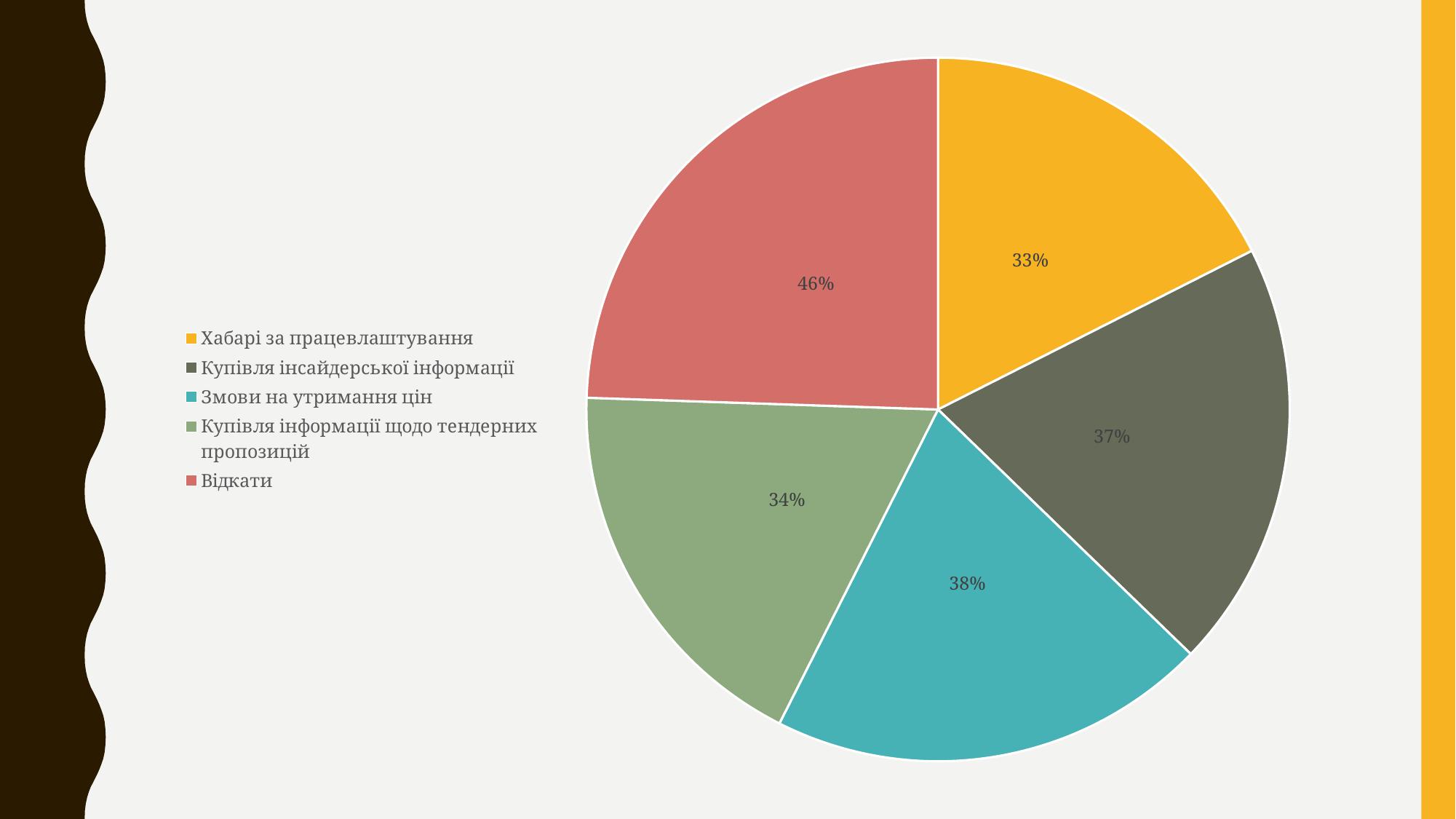
How many entries does the legend list? 5 What kind of chart is shown on the slide? pie chart What value is labelled on the slice for Купівля інформації щодо тендерних пропозицій? 34% What value is labelled on the slice for Відкати? 46% How many slices does the pie chart have? 5 Which category has the smallest slice in the pie chart? Хабарі за працевлаштування Which category has the largest slice in the pie chart? Відкати What value is labelled on the slice for Хабарі за працевлаштування? 33% Which colour is used for the Відкати slice? red What value is labelled on the slice for Купівля інсайдерської інформації? 37% What is the difference between the labelled values for Відкати and Хабарі за працевлаштування? 13% What value is labelled on the slice for Змови на утримання цін? 38%